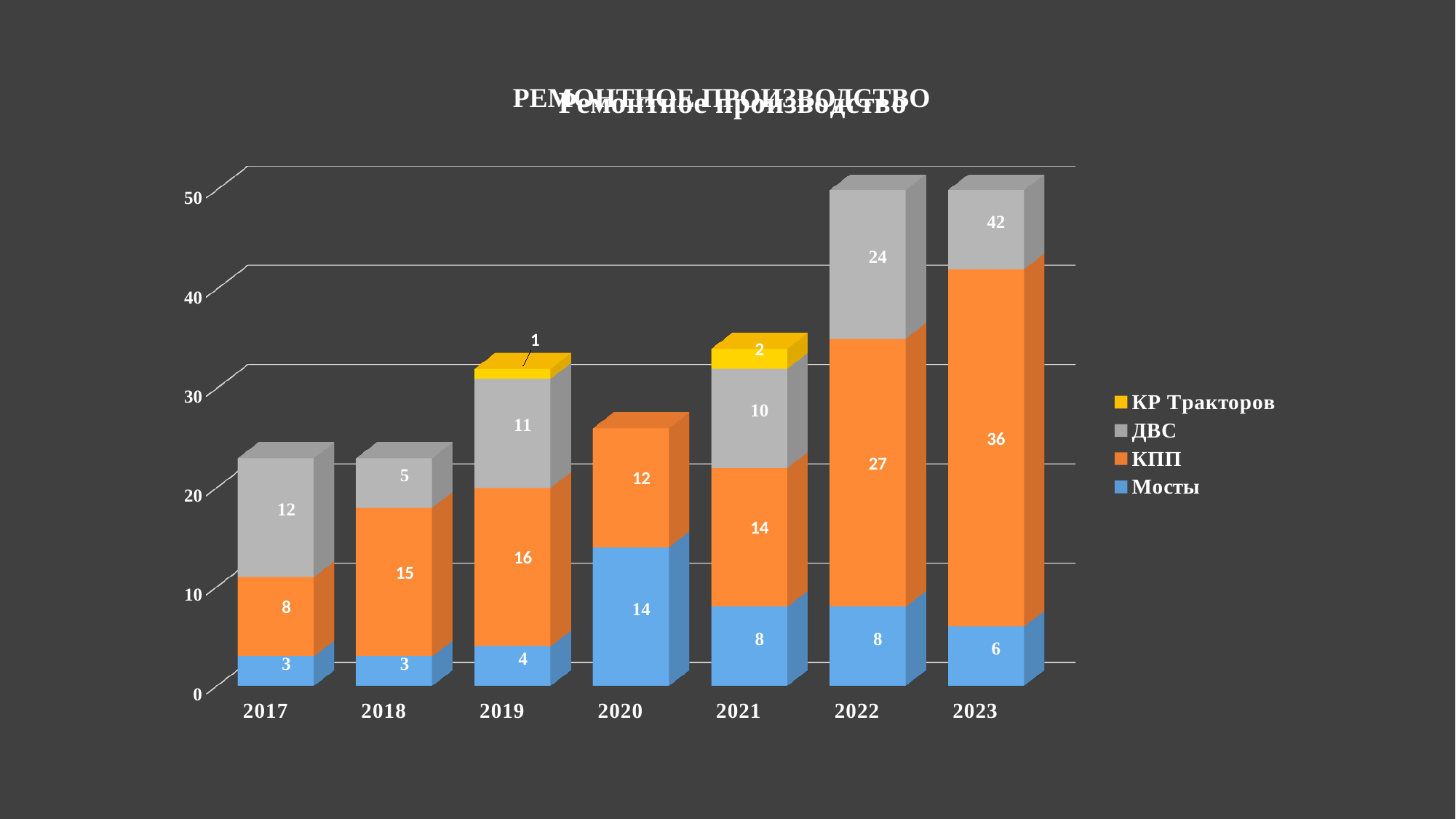
What is the total of the stacked bar for 2019? 32 What is the difference between the КПП values for 2023 and 2022? 9 In which year is the КПП value lowest? 2017 How many series does the legend list? 4 What kind of chart is shown on the slide? Stacked bar chart What is the value for КПП in 2022? 27 What is the value for КР Тракторов in 2021? 2 In which year is the ДВС value highest? 2023 What is the value for ДВС in 2018? 5 Which is larger: the Мосты value in 2020 or the Мосты value in 2021? 2020 What is the value for Мосты in 2020? 14 How many years are shown on the x axis? 7